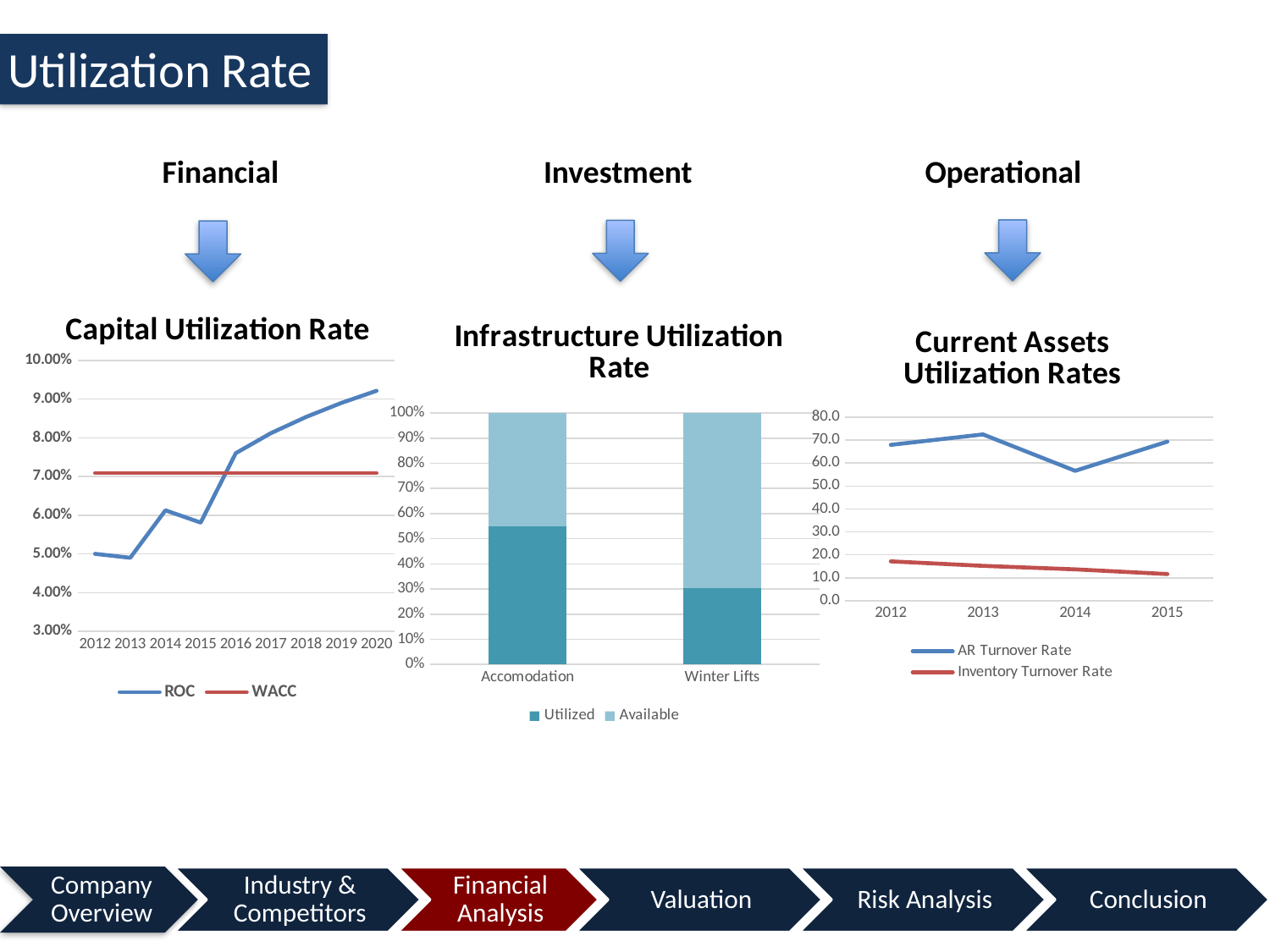
In the Infrastructure Utilization Rate chart, is the Utilized value for Winter Lifts greater or less than 40%? less In the Capital Utilization Rate chart, is the ROC value for 2020 greater or less than 9.00%? greater What kind of chart is the Infrastructure Utilization Rate chart? stacked bar chart In the Capital Utilization Rate chart, is the ROC value for 2015 greater or less than 6.00%? less In the Current Assets Utilization Rates chart, which year has the lowest AR Turnover Rate? 2014 In the Capital Utilization Rate chart, does the ROC line generally rise or fall from 2012 to 2020? rise In the Current Assets Utilization Rates chart, does the Inventory Turnover Rate rise or fall from 2012 to 2015? fall In the Infrastructure Utilization Rate chart, which category has the larger Utilized share, Accomodation or Winter Lifts? Accomodation How many series does the legend of the Capital Utilization Rate chart list? 2 In the Capital Utilization Rate chart, which year has the highest ROC value? 2020 What kind of chart is the Capital Utilization Rate chart? line chart How many years are shown on the x axis of the Current Assets Utilization Rates chart? 4